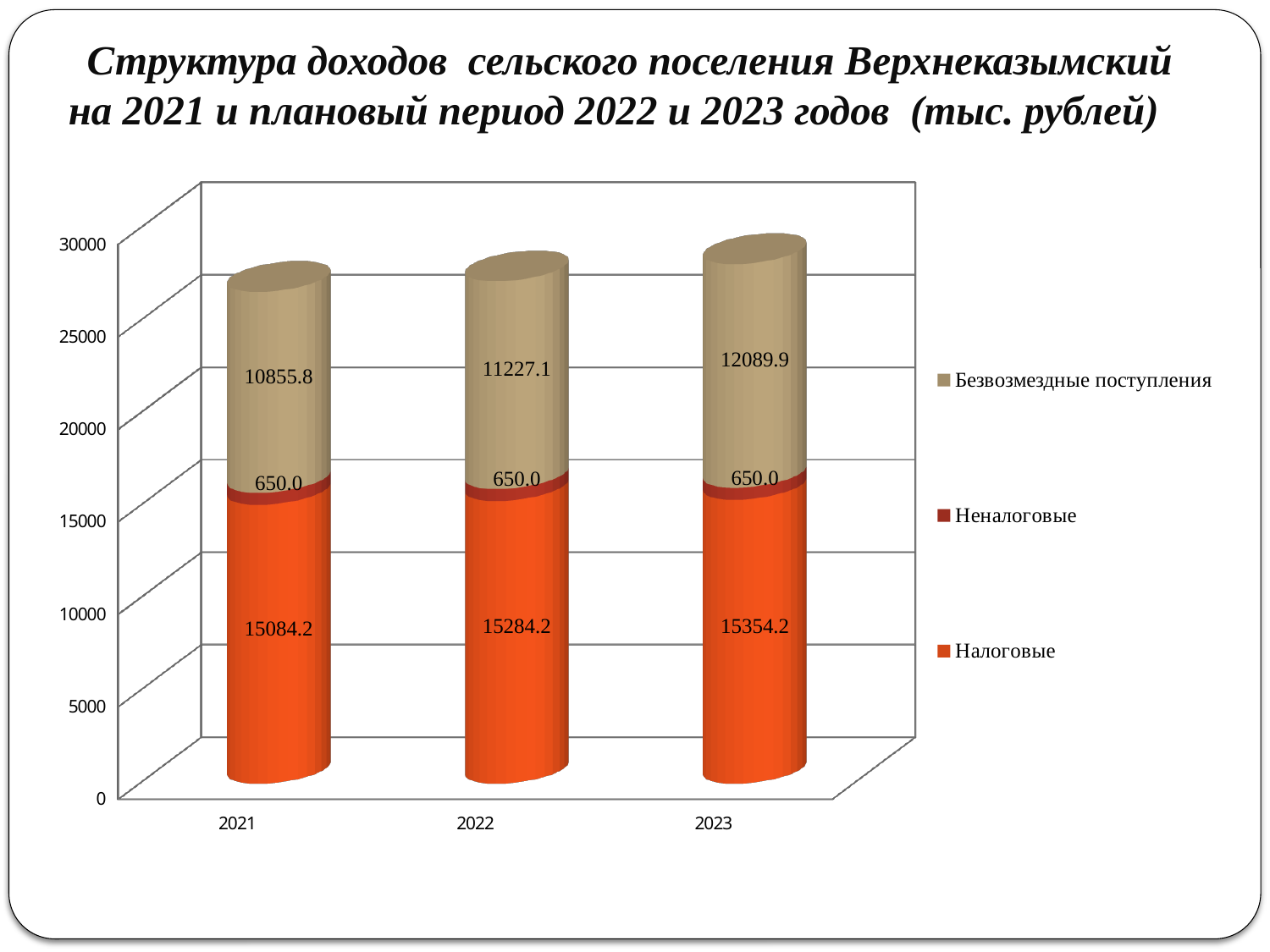
What is the difference between Безвозмездные поступления in 2023 and in 2021? 1234.1 What kind of chart is shown on the slide? Stacked bar chart Which is larger: Безвозмездные поступления in 2022 or in 2021? 2022 How many series does the legend list? 3 What is the value of Неналоговые for 2022? 650.0 What is the value of Безвозмездные поступления for 2023? 12089.9 What is the total of the stacked bar for 2023? 28094.1 What is the difference between Налоговые in 2022 and in 2021? 200.0 What is the value of Налоговые for 2021? 15084.2 What is the total of the stacked bar for 2021? 26590.0 In which year is Безвозмездные поступления the highest? 2023 In which year is Налоговые the lowest? 2021